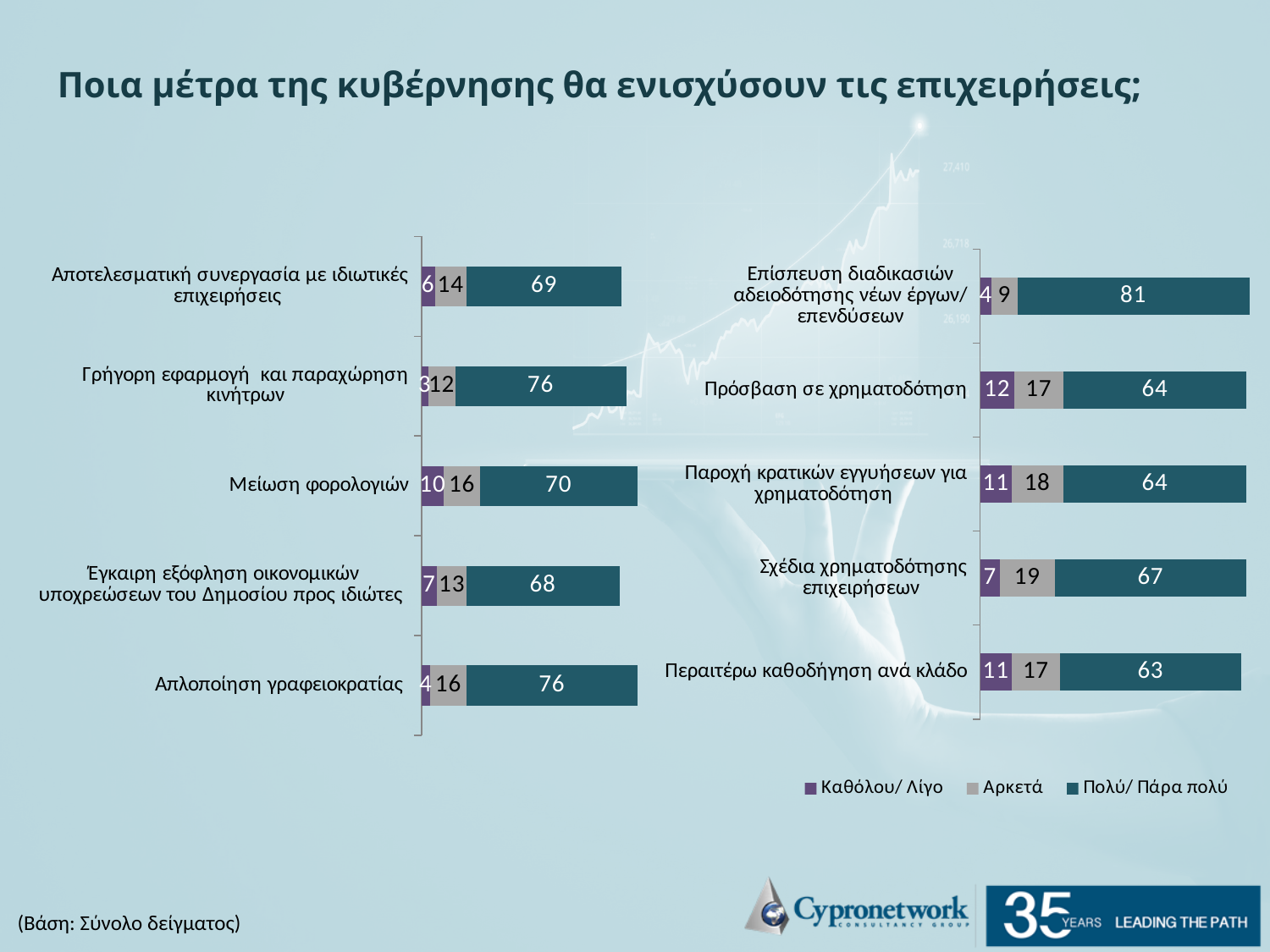
In the right chart, what is the total of the stacked bar for 'Πρόσβαση σε χρηματοδότηση'? 93 In the left chart, what is the 'Πολύ/ Πάρα πολύ' value for 'Μείωση φορολογιών'? 70 What type of chart is the left chart? Stacked bar chart In the right chart, what is the difference between the 'Πολύ/ Πάρα πολύ' values for 'Επίσπευση διαδικασιών αδειοδότησης νέων έργων/ επενδύσεων' and 'Περαιτέρω καθοδήγηση ανά κλάδο'? 18 In the left chart, what is the 'Καθόλου/ Λίγο' value for 'Έγκαιρη εξόφληση οικονομικών υποχρεώσεων του Δημοσίου προς ιδιώτες'? 7 In the left chart, which category has the lowest 'Καθόλου/ Λίγο' value? Γρήγορη εφαρμογή και παραχώρηση κινήτρων In the right chart, what is the 'Αρκετά' value for 'Σχέδια χρηματοδότησης επιχειρήσεων'? 19 How many series does the legend list? 3 In the right chart, which category has the highest 'Πολύ/ Πάρα πολύ' value? Επίσπευση διαδικασιών αδειοδότησης νέων έργων/ επενδύσεων In the left chart, which is larger: the 'Πολύ/ Πάρα πολύ' value for 'Απλοποίηση γραφειοκρατίας' or for 'Αποτελεσματική συνεργασία με ιδιωτικές επιχειρήσεις'? Απλοποίηση γραφειοκρατίας In the right chart, what is the 'Πολύ/ Πάρα πολύ' value for 'Επίσπευση διαδικασιών αδειοδότησης νέων έργων/ επενδύσεων'? 81 How many categories are shown in the right chart? 5